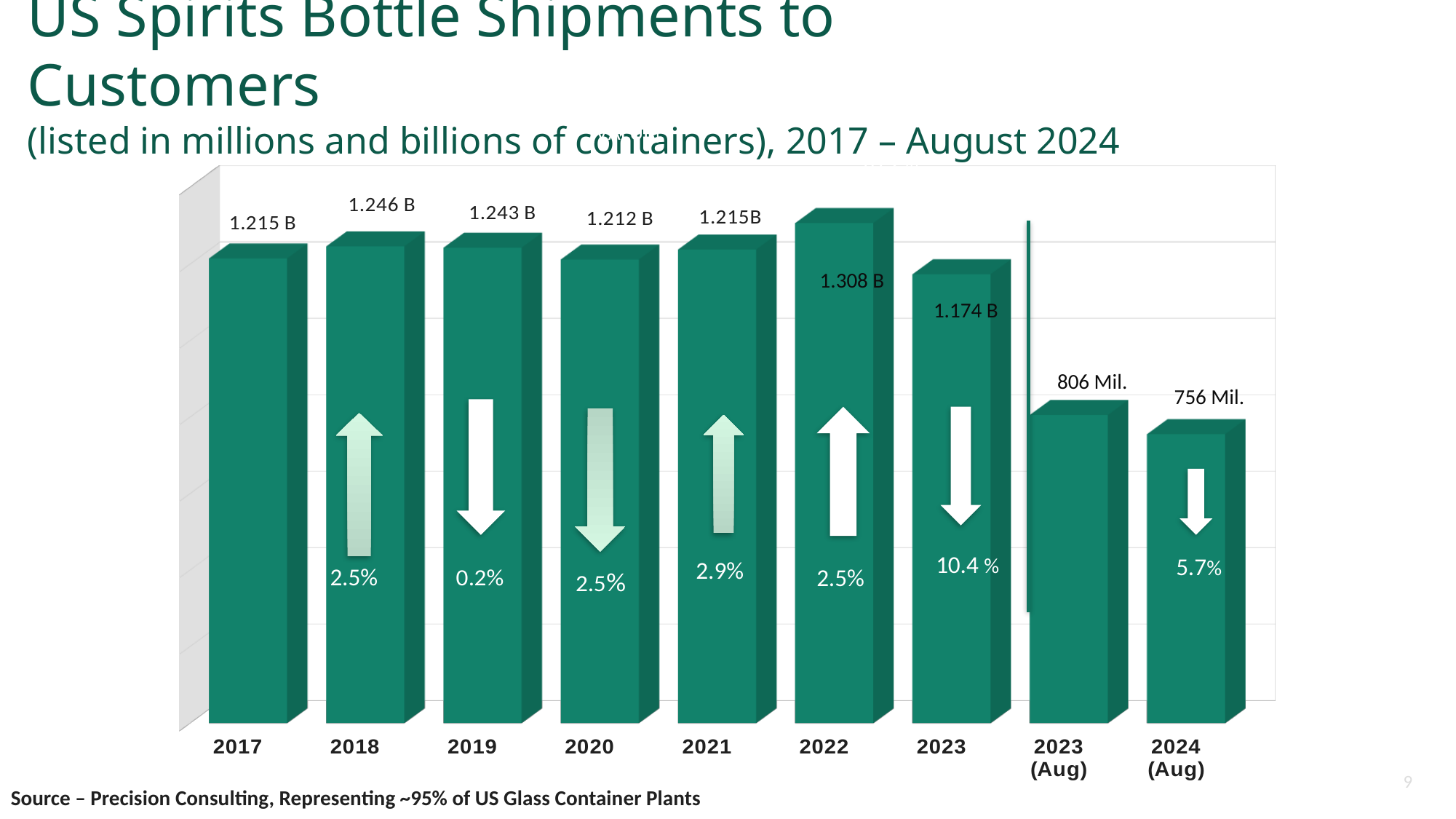
How many bars are shown on the chart? 9 Does the arrow on the 2021 bar point up or down? Up What source is cited below the chart? Precision Consulting, Representing ~95% of US Glass Container Plants Which category has the lowest value on the chart? 2024 (Aug) What kind of chart is shown on the slide? Bar chart What is the value shown for 2018? 1.246 B What is the value shown for 2024 (Aug)? 756 Mil. Which is larger, the value for 2022 or the value for 2020? 2022 What is the difference between the 2023 (Aug) and 2024 (Aug) values? 50 Mil. What is the value shown for 2022? 1.308 B What percentage change is shown on the 2023 bar? 10.4 % Which year has the highest shipment value? 2022